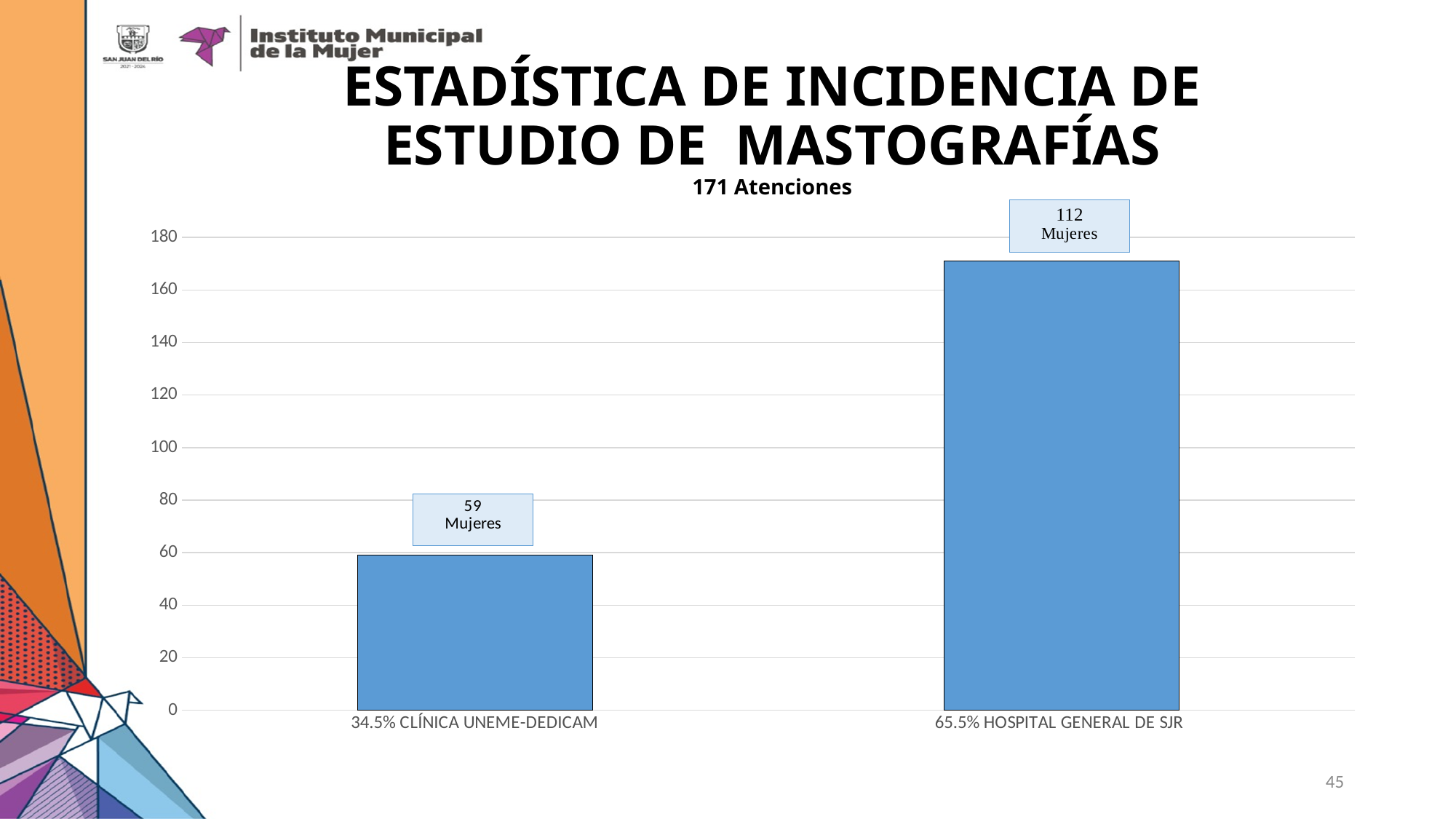
Which category has the lowest value? CLÍNICA UNEME-DEDICAM What percentage is shown in the x-axis label for HOSPITAL GENERAL DE SJR? 65.5% What is the total of the two values shown in the chart? 171 How many women (Mujeres) are shown for CLÍNICA UNEME-DEDICAM? 59 Which category has the highest value? HOSPITAL GENERAL DE SJR Is the value for CLÍNICA UNEME-DEDICAM greater or less than 80? less What is the difference between the values for HOSPITAL GENERAL DE SJR and CLÍNICA UNEME-DEDICAM? 53 How many women (Mujeres) are shown for HOSPITAL GENERAL DE SJR? 112 How many categories are shown on the x axis? 2 Which is larger, the value for CLÍNICA UNEME-DEDICAM or the value for HOSPITAL GENERAL DE SJR? HOSPITAL GENERAL DE SJR What is the subtitle shown directly above the chart? 171 Atenciones What kind of chart is shown on the slide? bar chart